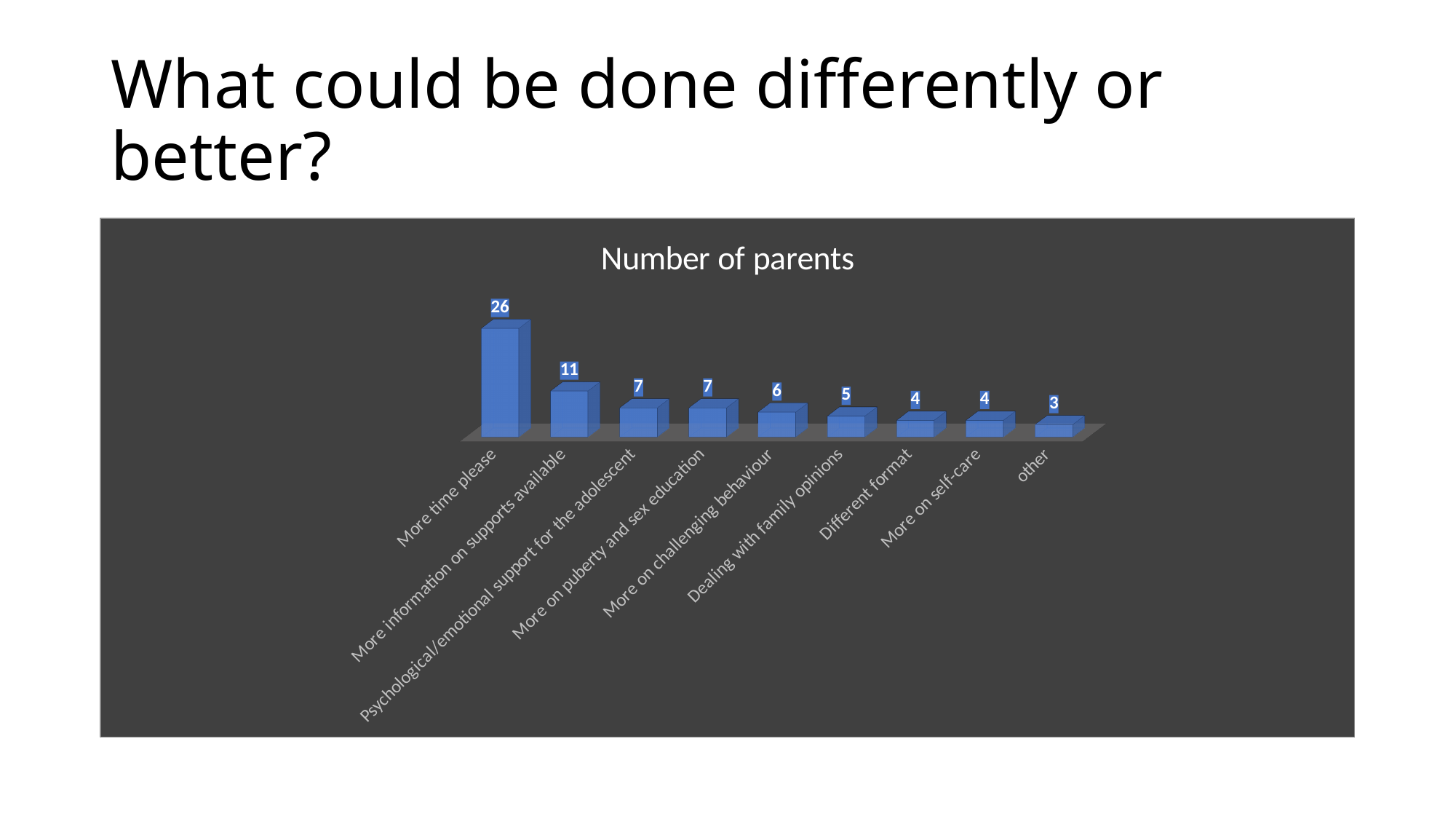
What is the number of parents for "other"? 3 What kind of chart is shown on the slide? Bar chart What is the number of parents for "More information on supports available"? 11 Which category has the lowest number of parents? other Do the values rise or fall from left to right along the x axis? Fall What is the number of parents for "More time please"? 26 What is the difference between the number of parents for "More time please" and "More information on supports available"? 15 How many categories are shown in the chart? 9 Which has more parents: "More on challenging behaviour" or "Different format"? More on challenging behaviour What is the title of the chart? Number of parents Which category has the highest number of parents? More time please What is the number of parents for "Dealing with family opinions"? 5